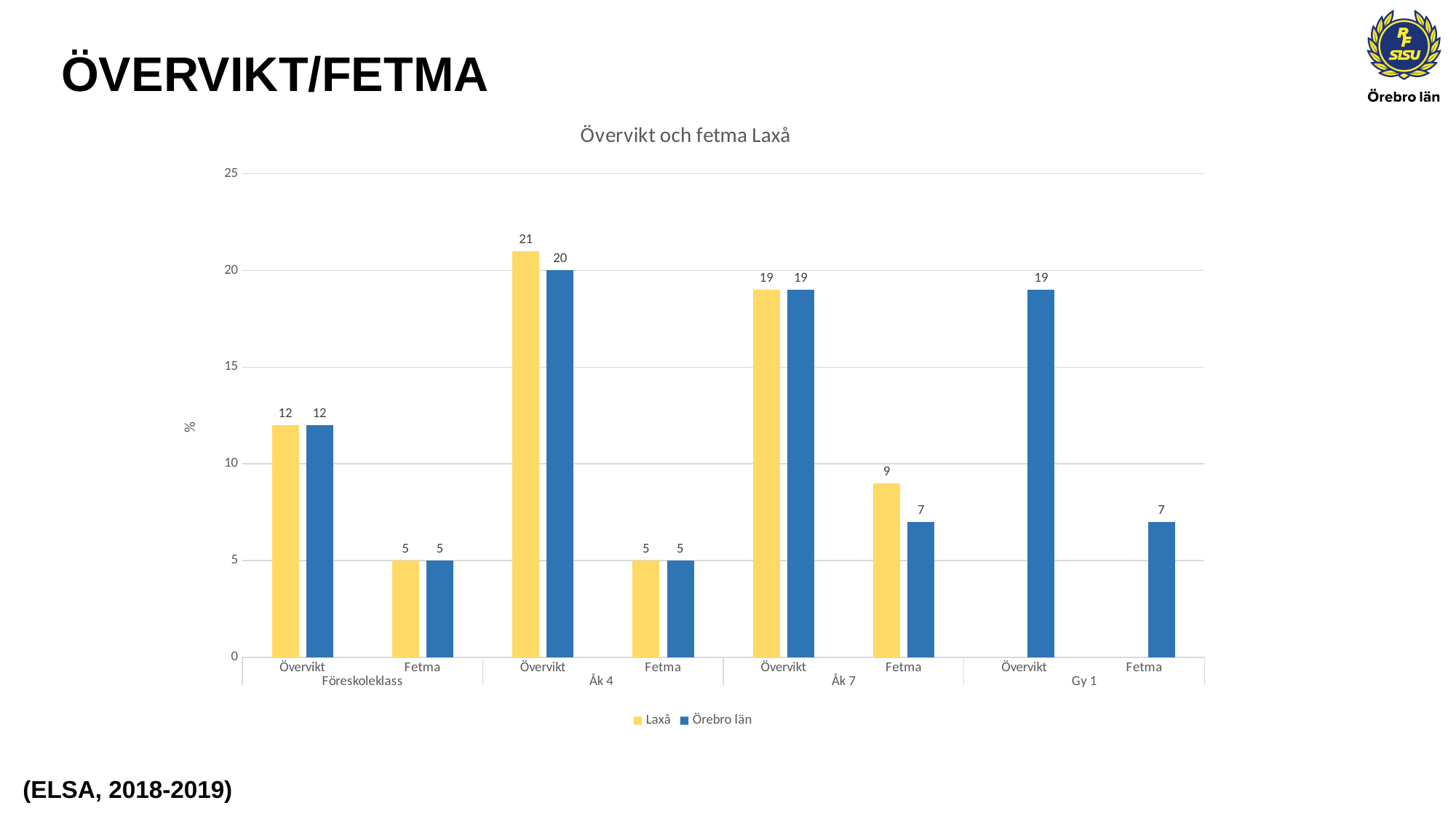
What is the value for Örebro län for Övervikt in Föreskoleklass? 12 How many series does the legend list? 2 Which is larger for Övervikt in Åk 4: Laxå or Örebro län? Laxå What type of chart is shown? bar chart What is the chart title? Övervikt och fetma Laxå What is the value for Laxå for Övervikt in Åk 4? 21 What is the value for Laxå for Fetma in Åk 7? 9 Which group has the highest Laxå value? Övervikt, Åk 4 Is the Örebro län value for Övervikt in Gy 1 greater or less than 15? greater Which series is shown in yellow? Laxå What is the difference between Laxå and Örebro län for Fetma in Åk 7? 2 What is the value for Örebro län for Fetma in Gy 1? 7